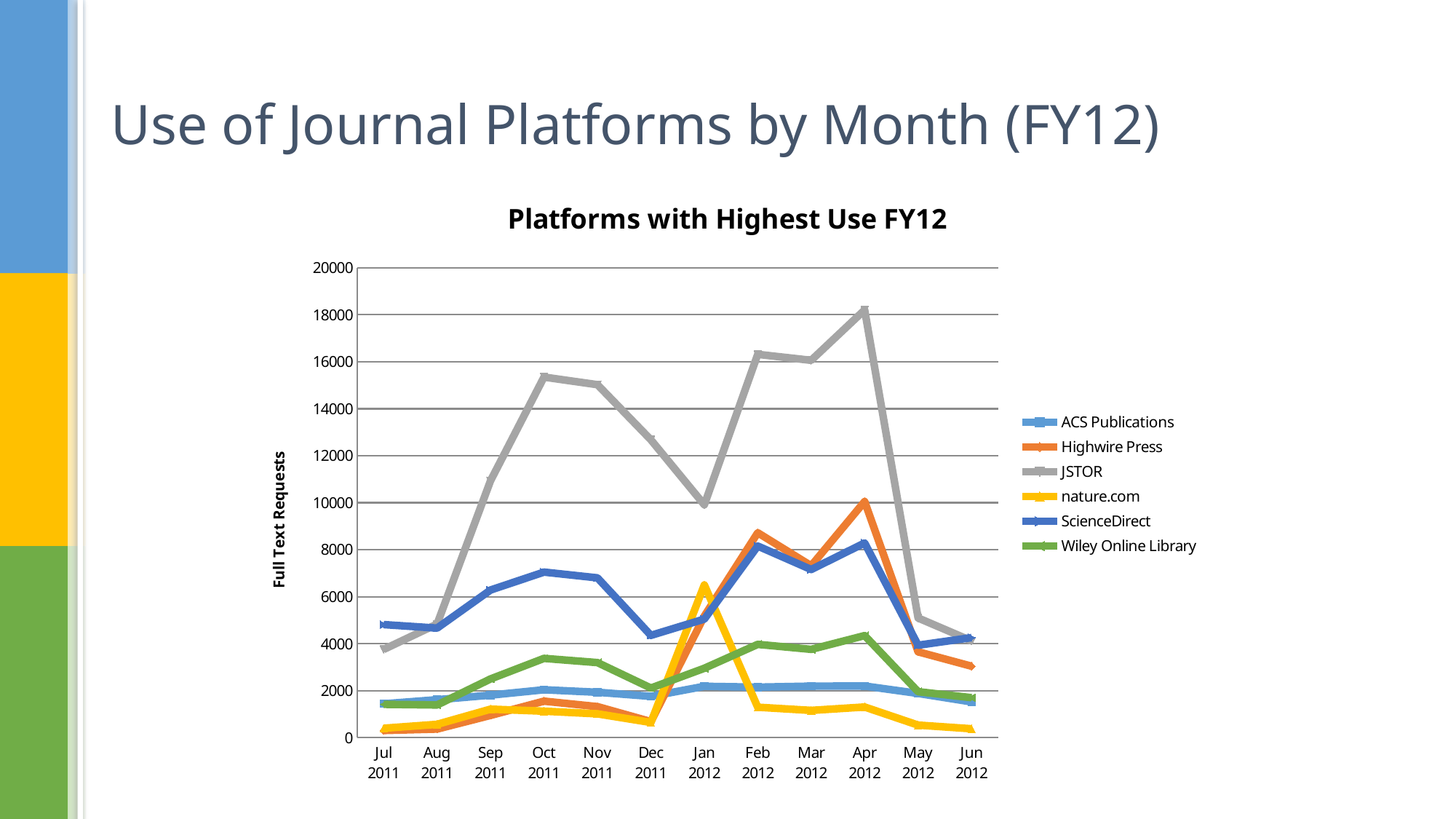
Does the JSTOR line rise or fall from Jul 2011 to Oct 2011? rise Which platform has the lowest value in Jun 2012? nature.com Which platform has the highest number of full text requests in Apr 2012? JSTOR Is the value for JSTOR in Jan 2012 greater or less than 12000? less Is the value for JSTOR in Apr 2012 greater or less than 16000? greater In Apr 2012, which is higher: Highwire Press or ScienceDirect? Highwire Press How many months are plotted along the x axis? 12 How many series does the legend list? 6 In which month does JSTOR reach its highest value? Apr 2012 What is the label on the vertical axis? Full Text Requests What is the title of the chart? Platforms with Highest Use FY12 What type of chart is shown on the slide? line chart